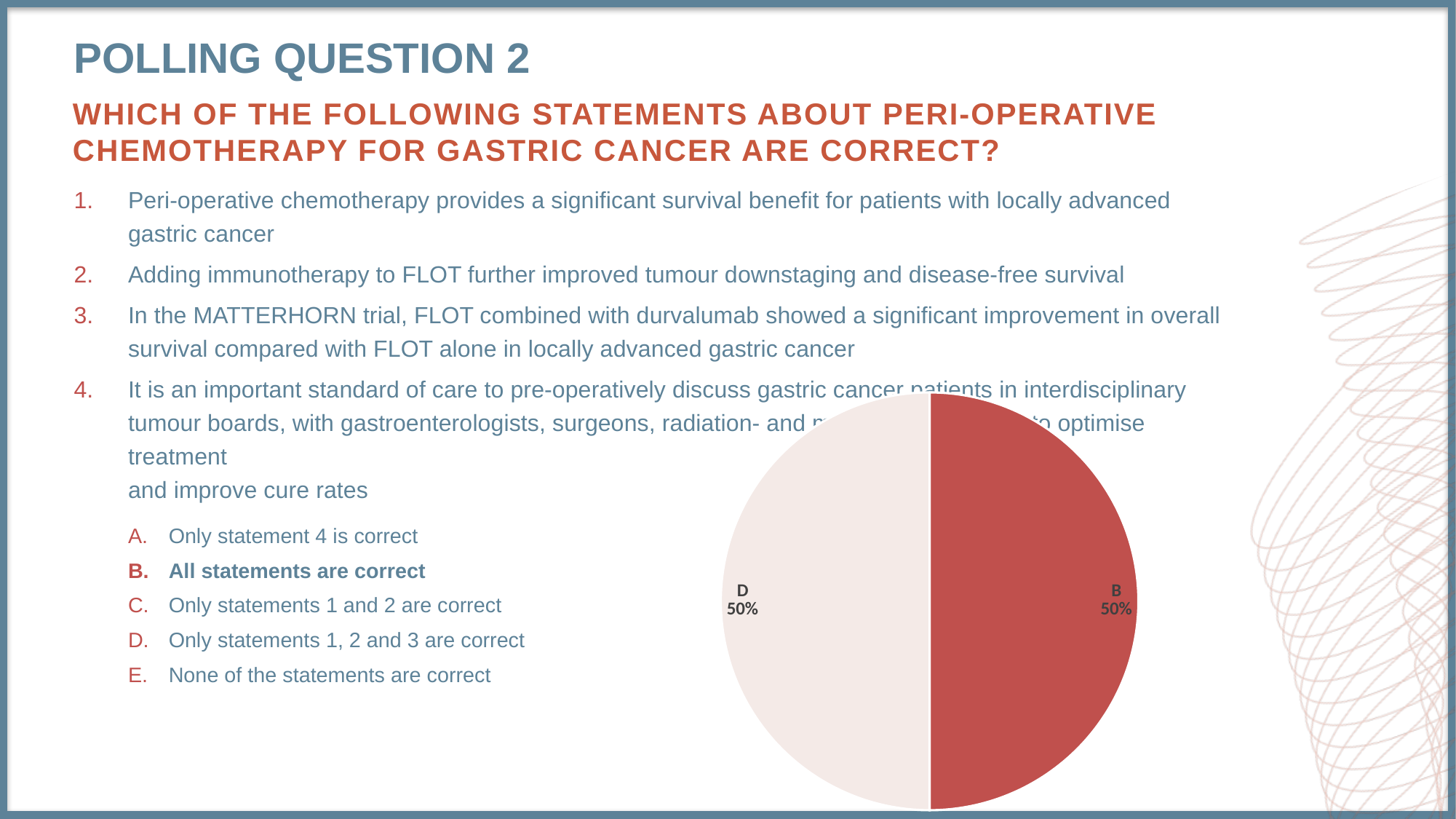
What is the combined total of slices B and D? 100% What share of the pie does slice D represent? 50% What is the value shown for slice D? 50% What is the value shown for slice B? 50% Which answer options appear as slices in the pie chart? B and D How many slices does the pie chart have? 2 What share of the pie does slice B represent? 50% What is the difference between the values for slice B and slice D? 0% Which slice of the pie chart is coloured red? B What kind of chart is shown on the slide? pie chart